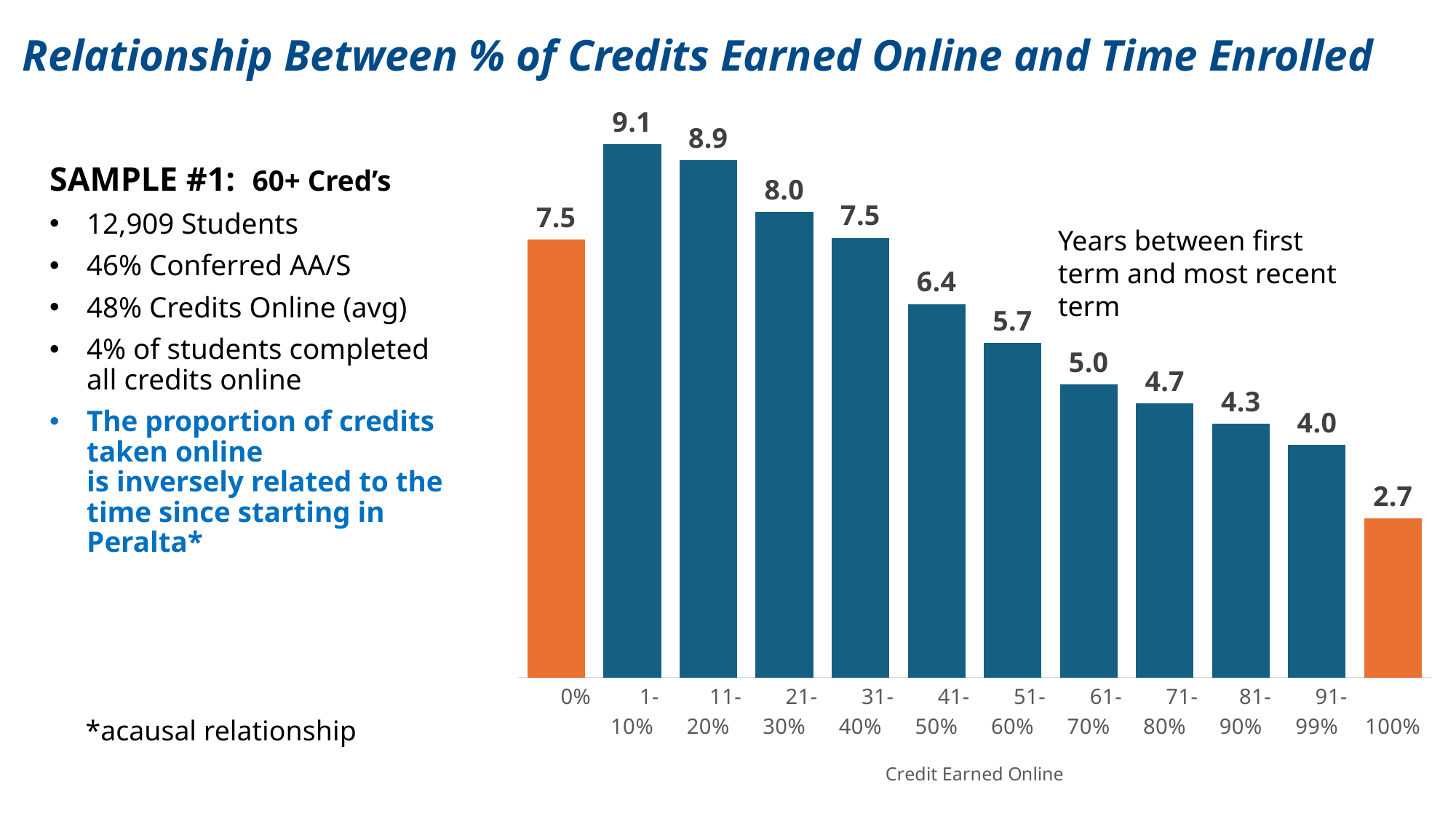
What is the difference between the values for 21-30% and 31-40%? 0.5 How many categories are shown on the x axis? 12 Which credit earned online category has the lowest value? 100% What is the value for the 51-60% credit earned online category? 5.7 What is the difference between the values for 1-10% and 100%? 6.4 What is the x axis title of the chart? Credit Earned Online What is the value for the 100% credit earned online category? 2.7 Which credit earned online category has the highest value? 1-10% What is the value for the 0% credit earned online category? 7.5 From the 1-10% category to the 100% category, do the values rise or fall? Fall What kind of chart is shown on the slide? Bar chart Which is larger, the value for 11-20% or the value for 41-50%? 11-20%